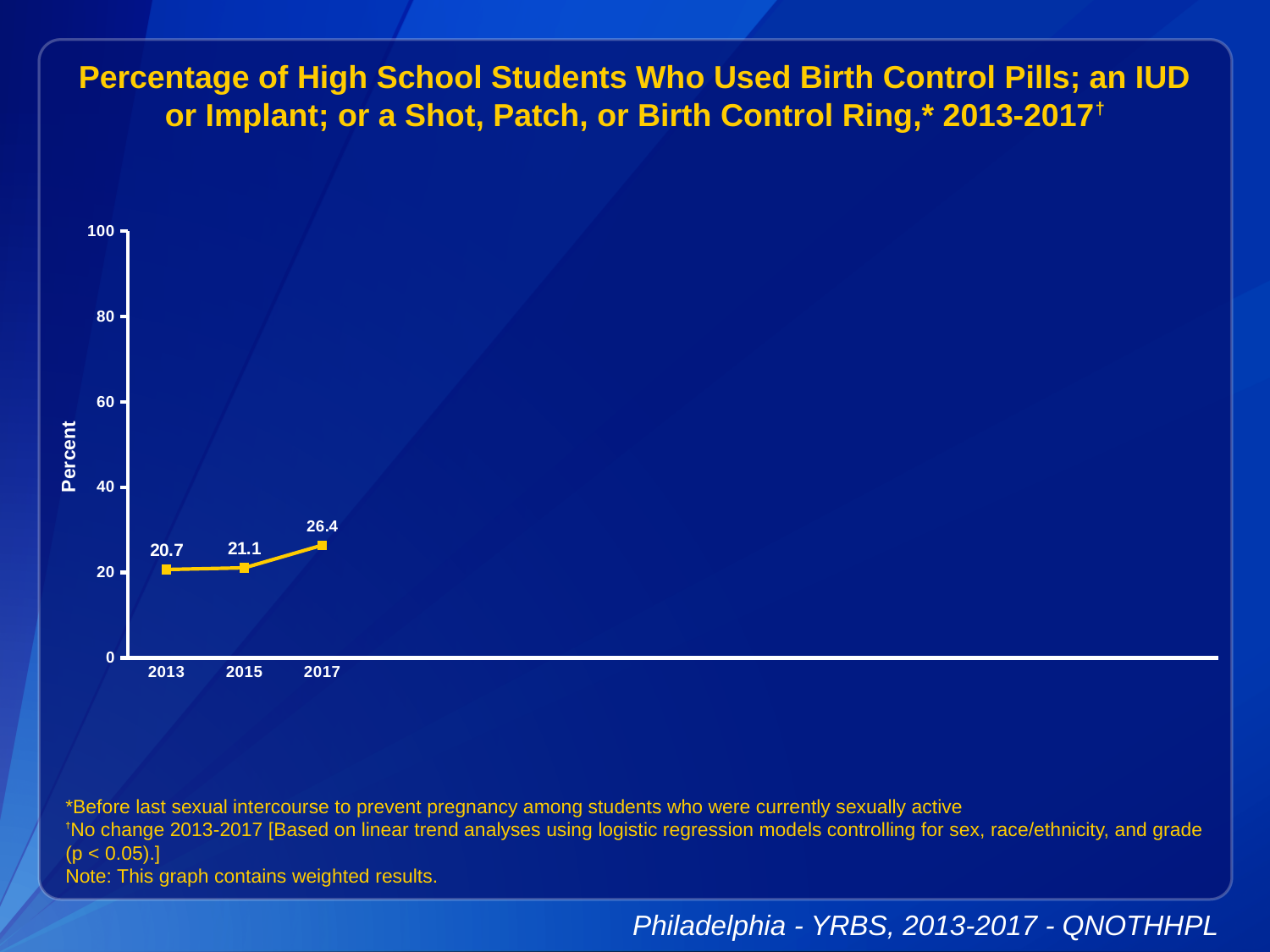
Which is larger, the value for 2015 or the value for 2017? 2017 Do the values rise or fall from 2013 to 2017? rise What kind of chart is shown? line chart Which year has the highest value? 2017 What is the difference between the 2017 and 2015 values? 5.3 What is the difference between the 2017 and 2013 values? 5.7 What is the value for 2013? 20.7 Is the value for 2017 greater or less than 40? less What is the value for 2015? 21.1 What is the value for 2017? 26.4 Which year has the lowest value? 2013 How many years are plotted on the chart? 3